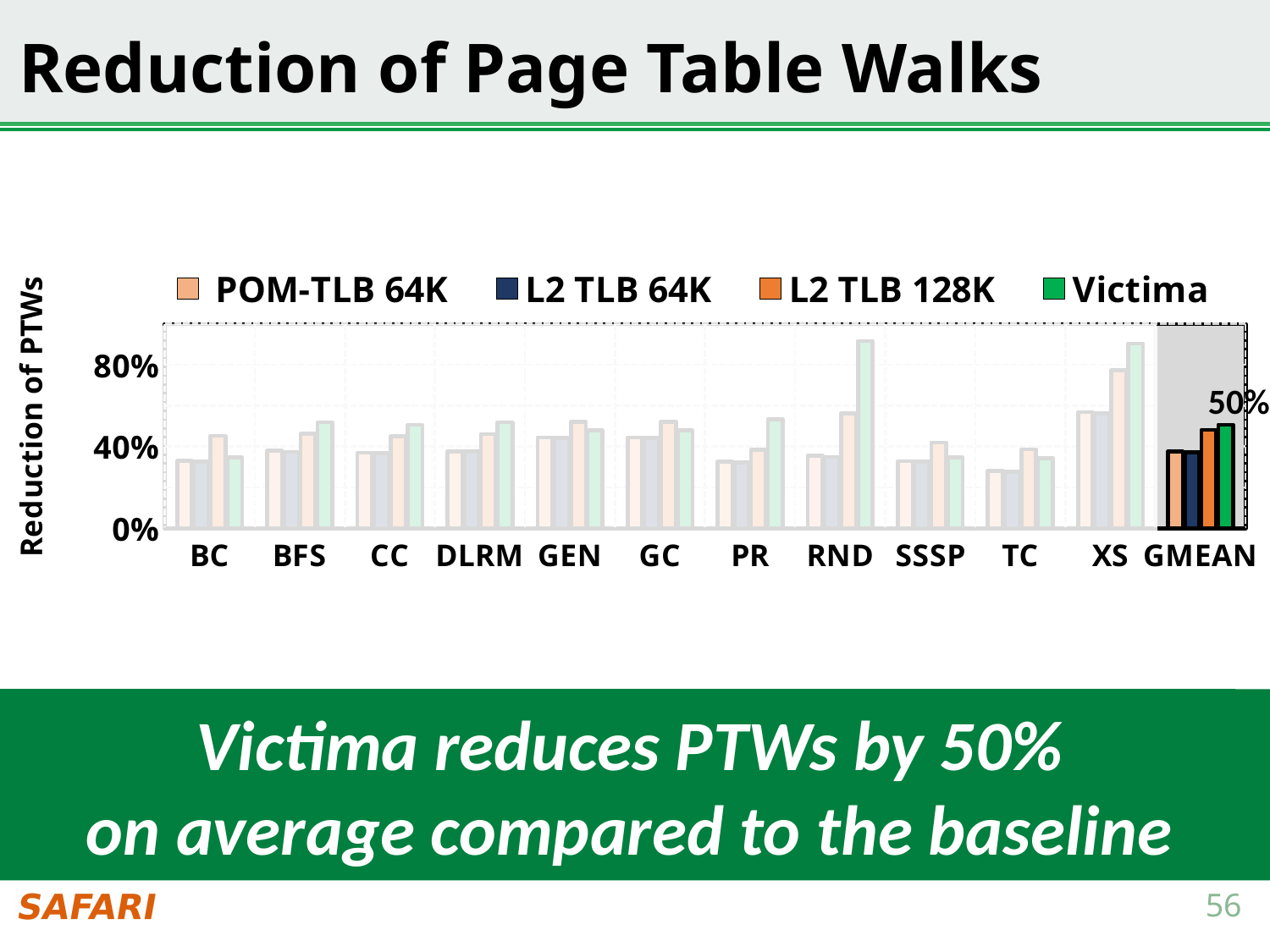
What is the label of the y axis? Reduction of PTWs For RND, which is larger: the Victima value or the POM-TLB 64K value? Victima Is the L2 TLB 64K value for TC greater or less than 40%? less What kind of chart is shown on the slide? bar chart How many series does the legend list? 4 Is the Victima value for PR greater or less than 40%? greater For GMEAN, which is larger: the Victima value or the L2 TLB 64K value? Victima Is the POM-TLB 64K value for BC greater or less than 40%? less How many categories are shown along the x axis? 12 What is the Victima value for GMEAN? 50%